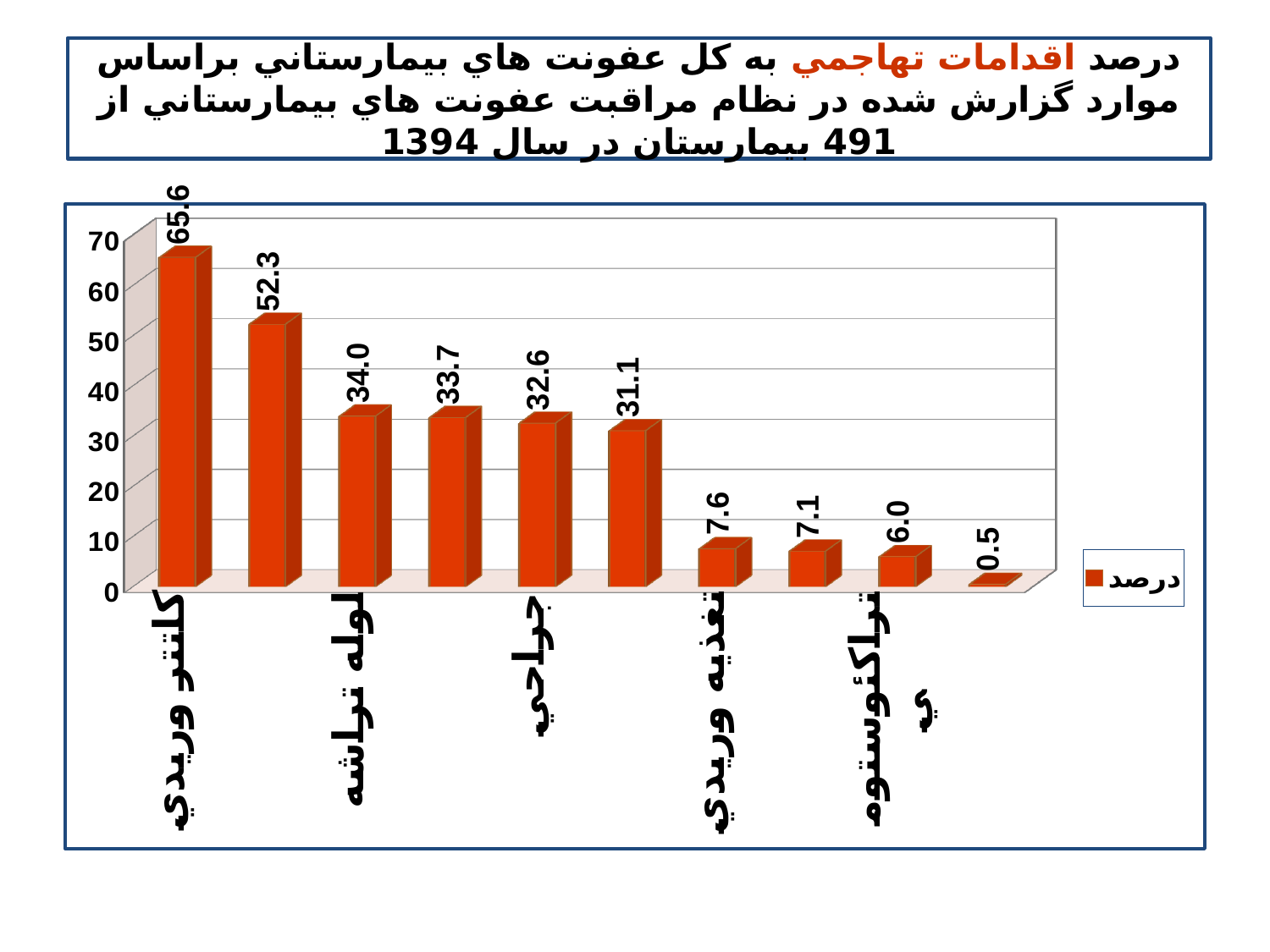
Which has the larger value, لوله تراشه or جراحی? لوله تراشه Which category has the highest value in the chart? کاتتر وریدی What is the value shown for جراحی? 32.6 What is the lowest value shown on any bar in the chart? 0.5 What kind of chart is shown on the slide? Bar chart What is the value shown for کاتتر وریدی? 65.6 What is the difference between the highest bar (65.6) and the second highest bar (52.3)? 13.3 Do the bar values rise or fall from left to right along the x axis? Fall What is the value shown for تغذیه وریدی? 7.6 What is the value shown for لوله تراشه? 34.0 How many bars are plotted in the chart? 10 How many series does the legend list? 1